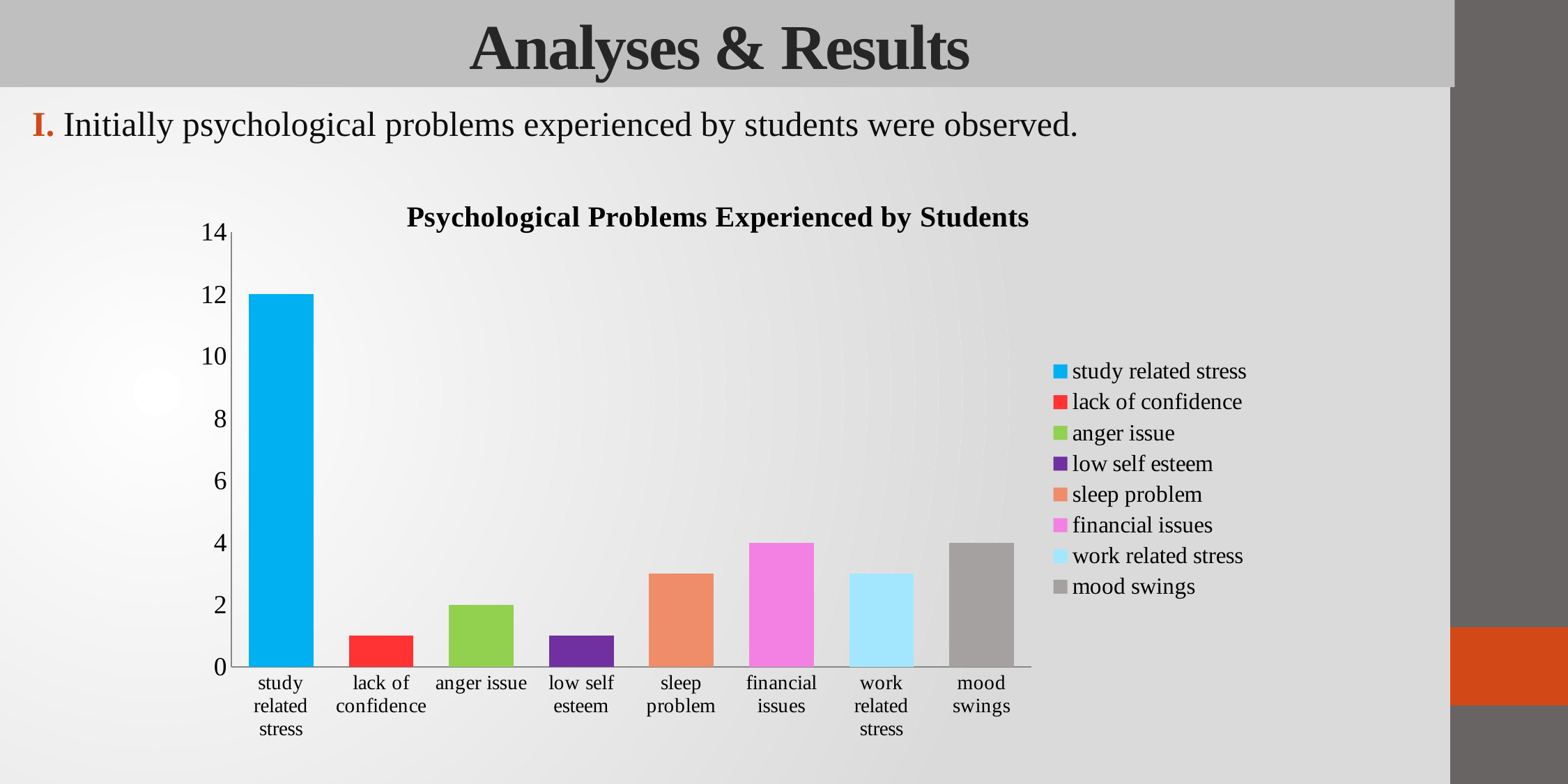
Is the value for lack of confidence greater or less than 2? less How many categories are shown on the x axis? 8 What type of chart is shown? bar chart Which category has the highest value? study related stress Which is larger, the value for sleep problem or the value for anger issue? sleep problem Is the value for work related stress greater or less than 2? greater What is the value for mood swings? 4 What is the value for study related stress? 12 What is the difference between the values for study related stress and anger issue? 10 What is the value for financial issues? 4 What is the value for anger issue? 2 What is the difference between the values for study related stress and financial issues? 8